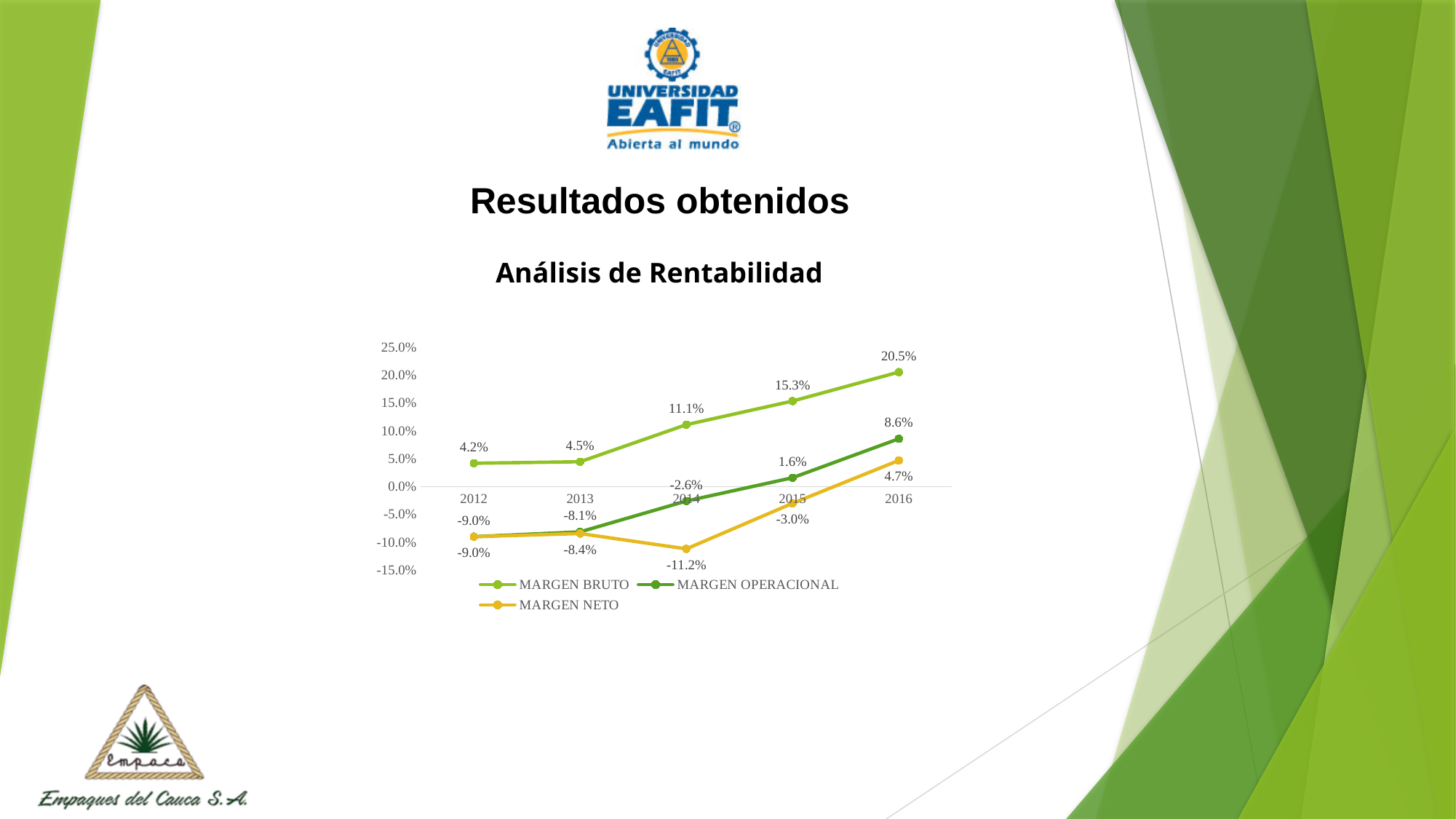
How many series does the legend list? 3 What type of chart is shown on the slide? line chart In which year is MARGEN BRUTO highest? 2016 What is the value of MARGEN NETO in 2014? -11.2% In which year is MARGEN NETO lowest? 2014 What is the title of the chart? Análisis de Rentabilidad What is the difference between MARGEN BRUTO in 2016 and in 2015? 5.2% Which is larger in 2016, MARGEN OPERACIONAL or MARGEN NETO? MARGEN OPERACIONAL Does MARGEN BRUTO rise or fall from 2012 to 2016? rise What is the value of MARGEN BRUTO in 2016? 20.5% How many years are shown on the x axis? 5 What is the value of MARGEN OPERACIONAL in 2014? -2.6%